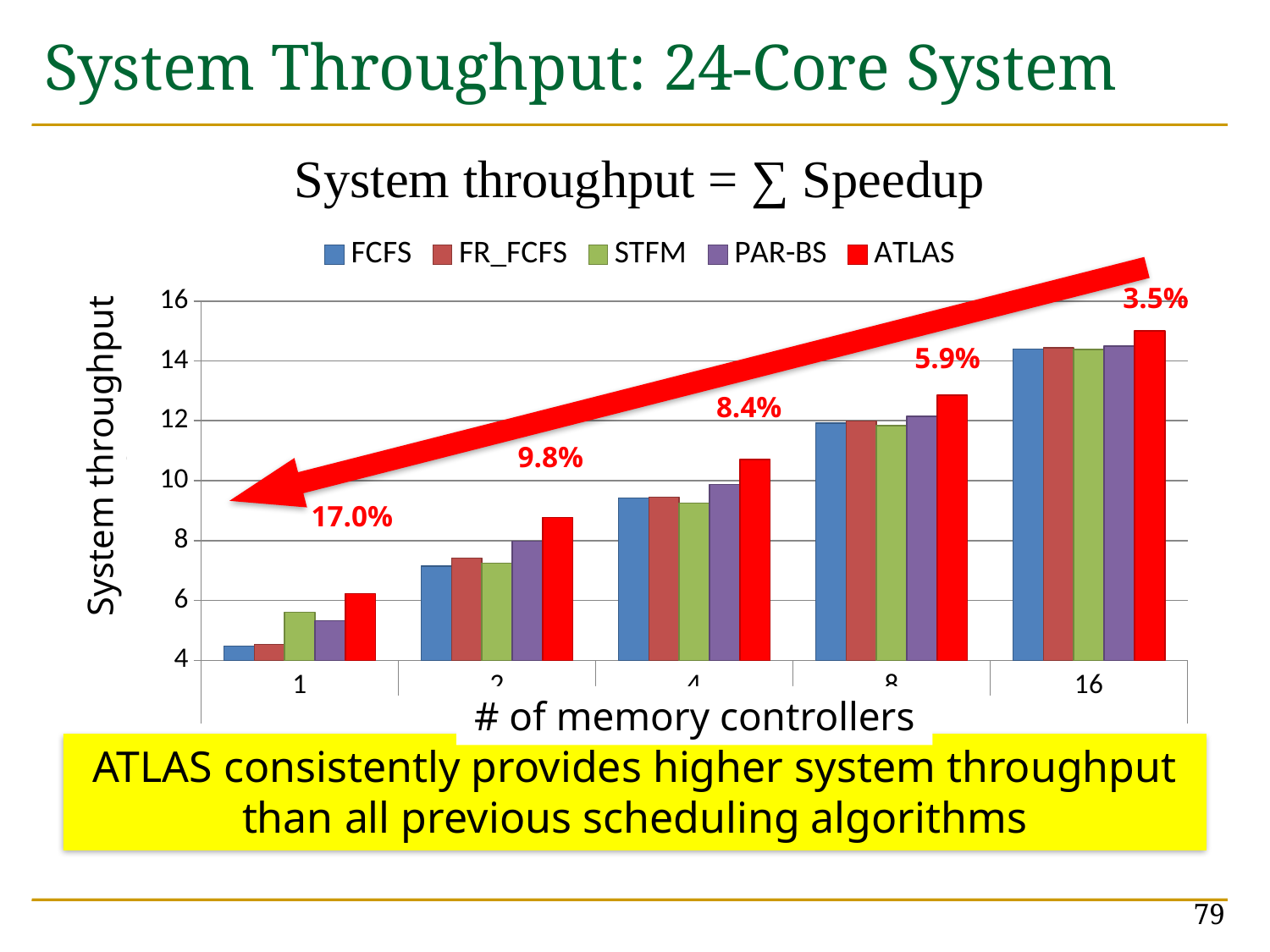
Which series has the highest system throughput for 16 memory controllers? ATLAS For which number of memory controllers is the ATLAS bar lowest? 1 Is the value for ATLAS at 8 memory controllers greater or less than 12? greater Which is larger at 8 memory controllers, the FCFS bar or the ATLAS bar? ATLAS What percentage label is printed above the group of bars for 1 memory controller? 17.0% What colour are the ATLAS bars in the chart? red Is the value for ATLAS at 16 memory controllers greater or less than 14? greater How many series does the legend list? 5 Is the value for FCFS at 1 memory controller greater or less than 6? less Do the system throughput values rise or fall as the number of memory controllers increases? rise How many groups of bars (memory controller counts) are plotted along the x axis? 5 What kind of chart is shown on the slide? bar chart